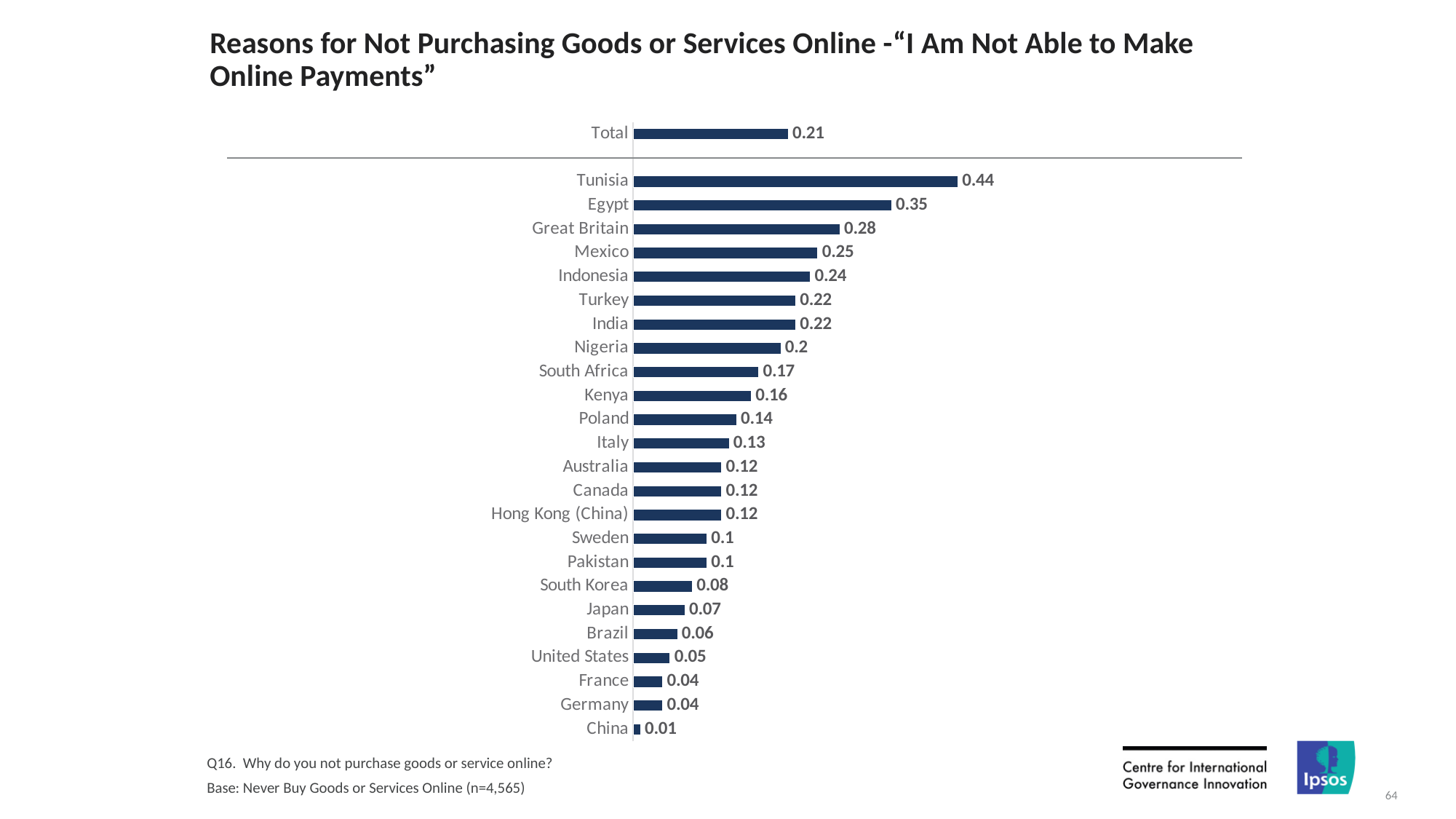
What is the value for Hong Kong (China)? 0.12 What is the value for Tunisia? 0.44 Which has a larger value, Japan or South Korea? South Korea What is the difference between the values for Great Britain and Mexico? 0.03 What is the difference between the values for Tunisia and Egypt? 0.09 What kind of chart is shown on the slide? Bar chart Which country has the highest value? Tunisia Which country has the lowest value? China What is the base sample size (n) stated at the bottom of the slide? 4,565 What is the value for Total? 0.21 How many countries are listed below the Total bar? 23 Which has a larger value, Indonesia or Nigeria? Indonesia